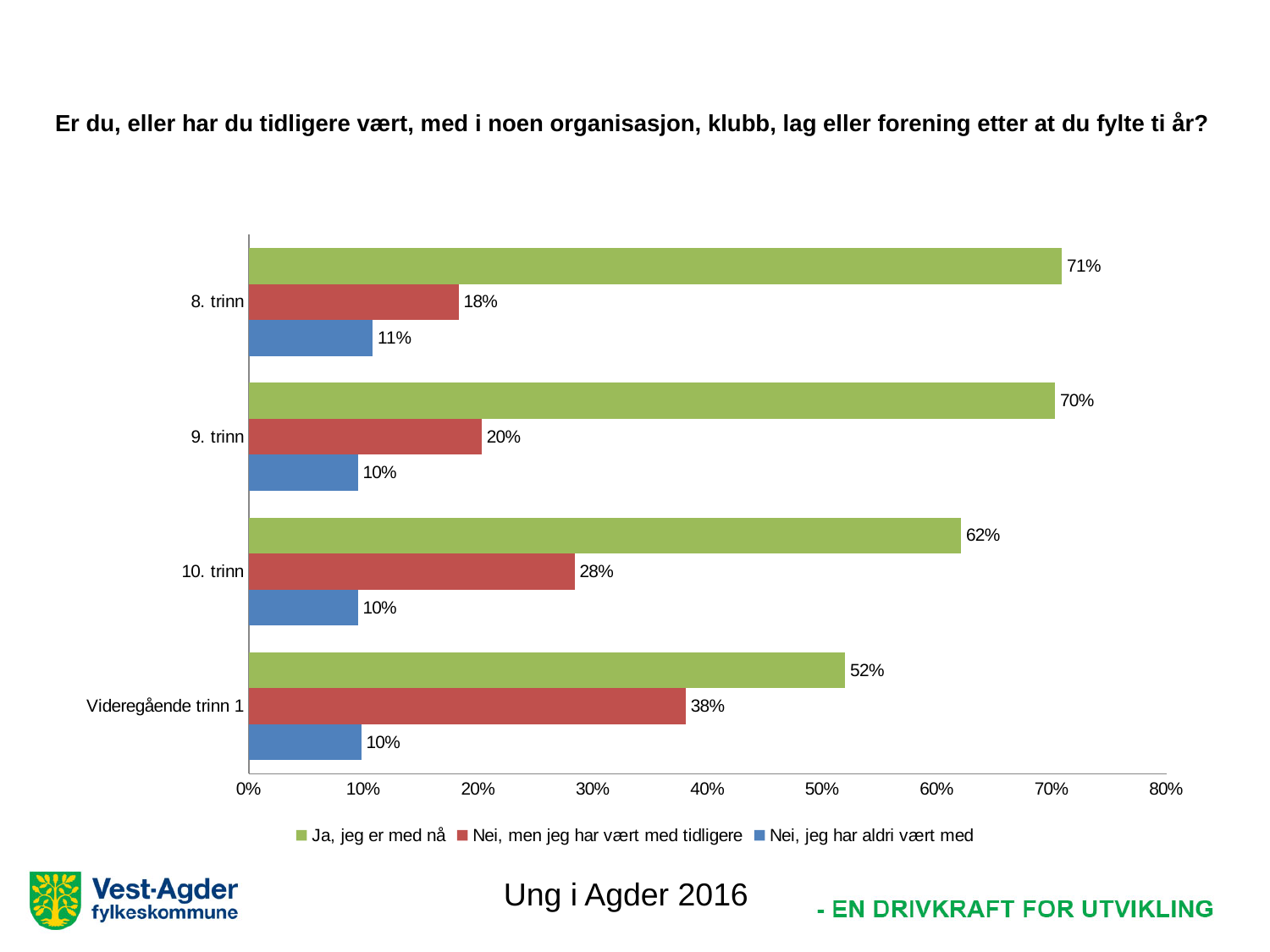
Which category has the highest value for "Nei, men jeg har vært med tidligere"? Videregående trinn 1 What is the value for "Nei, jeg har aldri vært med" for 8. trinn? 11% Which category has the lowest value for "Ja, jeg er med nå"? Videregående trinn 1 What is the value for "Nei, men jeg har vært med tidligere" for Videregående trinn 1? 38% What is the value for "Ja, jeg er med nå" for 8. trinn? 71% Is the value for "Ja, jeg er med nå" for 10. trinn greater or less than 60%? greater What is the difference between the "Ja, jeg er med nå" values for 8. trinn and Videregående trinn 1? 19% What kind of chart is shown on the slide? Bar chart Which is larger: "Nei, men jeg har vært med tidligere" for 10. trinn or for 9. trinn? 10. trinn How many categories are shown on the y axis? 4 How many series does the legend list? 3 Which colour represents "Nei, jeg har aldri vært med" in the legend? Blue